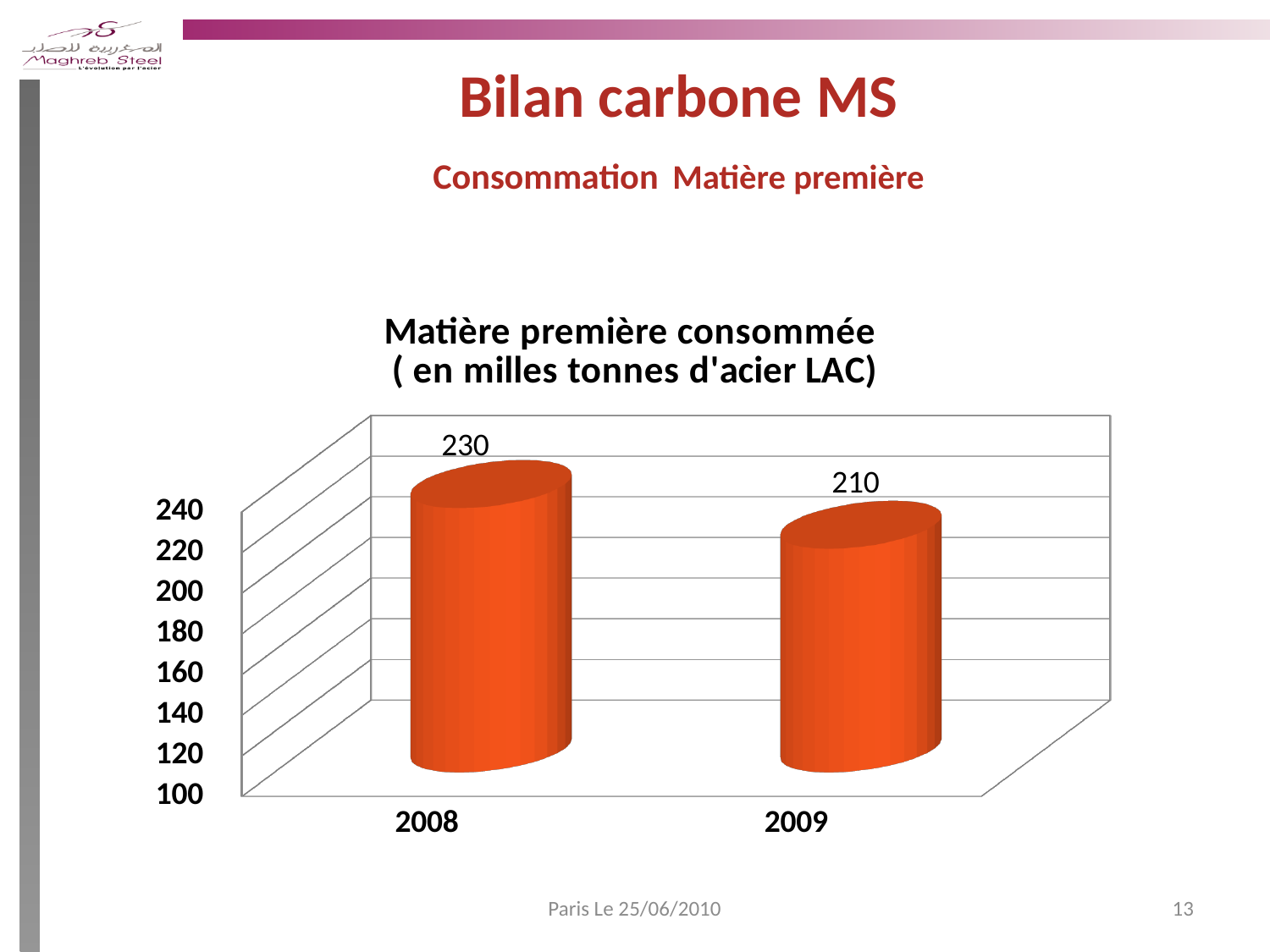
What is the value for 2009? 210 What is the difference between the values for 2008 and 2009? 20 Is the value for 2009 greater or less than 200? greater Is the value for 2008 greater or less than 240? less Do the values rise or fall from 2008 to 2009? fall Which is larger, the value for 2008 or the value for 2009? 2008 What is the title of the chart? Matière première consommée ( en milles tonnes d'acier LAC) What kind of chart is shown? bar chart Which year has the lowest value? 2009 What is the value for 2008? 230 How many categories are shown on the x axis? 2 Which year has the highest value? 2008